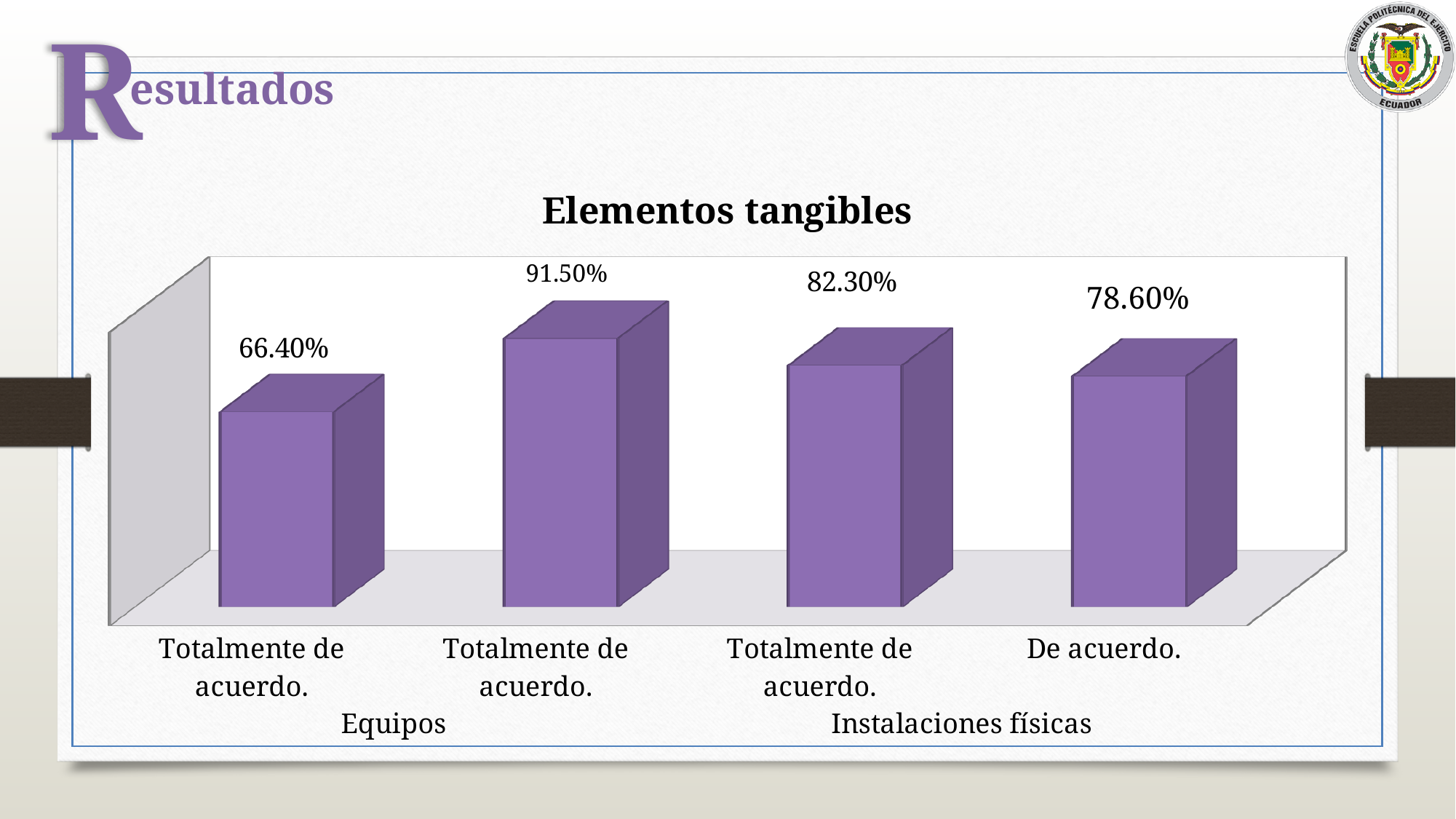
Which is larger: the 'Totalmente de acuerdo.' bar under Instalaciones físicas or the 'De acuerdo.' bar under Instalaciones físicas? Totalmente de acuerdo. (82.30%) What are the two group labels shown below the category labels? Equipos and Instalaciones físicas What is the value of the second bar, under Equipos? 91.50% What is the title of the chart? Elementos tangibles What is the value of the 'Totalmente de acuerdo.' bar under Instalaciones físicas? 82.30% What is the value of the 'De acuerdo.' bar under Instalaciones físicas? 78.60% What is the difference between the highest bar (91.50%) and the lowest bar (66.40%)? 25.10% Which bar has the lowest value? the first bar (Totalmente de acuerdo., Equipos), 66.40% What is the value of the first (leftmost) bar, under Equipos? 66.40% Which bar has the highest value? the second bar (Totalmente de acuerdo., Equipos), 91.50% What type of chart is shown on the slide? bar chart How many bars are plotted in the chart? 4